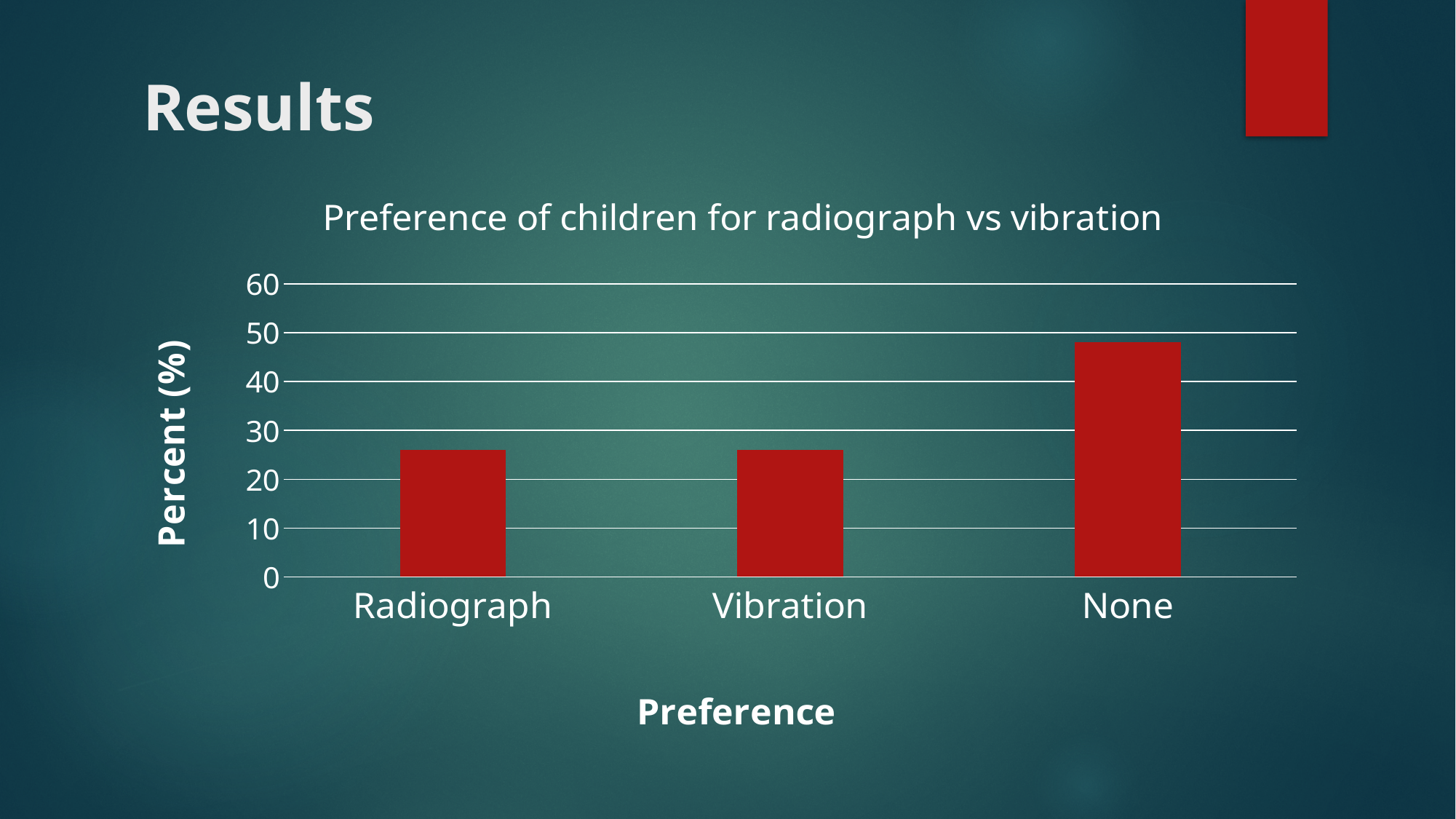
Is the value for None greater or less than 40? greater What is the label of the y axis of the chart? Percent (%) Which is larger, the value for None or the value for Radiograph? None How many categories are shown on the x axis of the chart? 3 Is the value for None greater or less than 50? less Is the value for Radiograph greater or less than 30? less Which is larger, the value for Vibration or the value for None? None What is the title of the chart? Preference of children for radiograph vs vibration Which category has the highest value in the chart? None What kind of chart is shown on the slide? bar chart